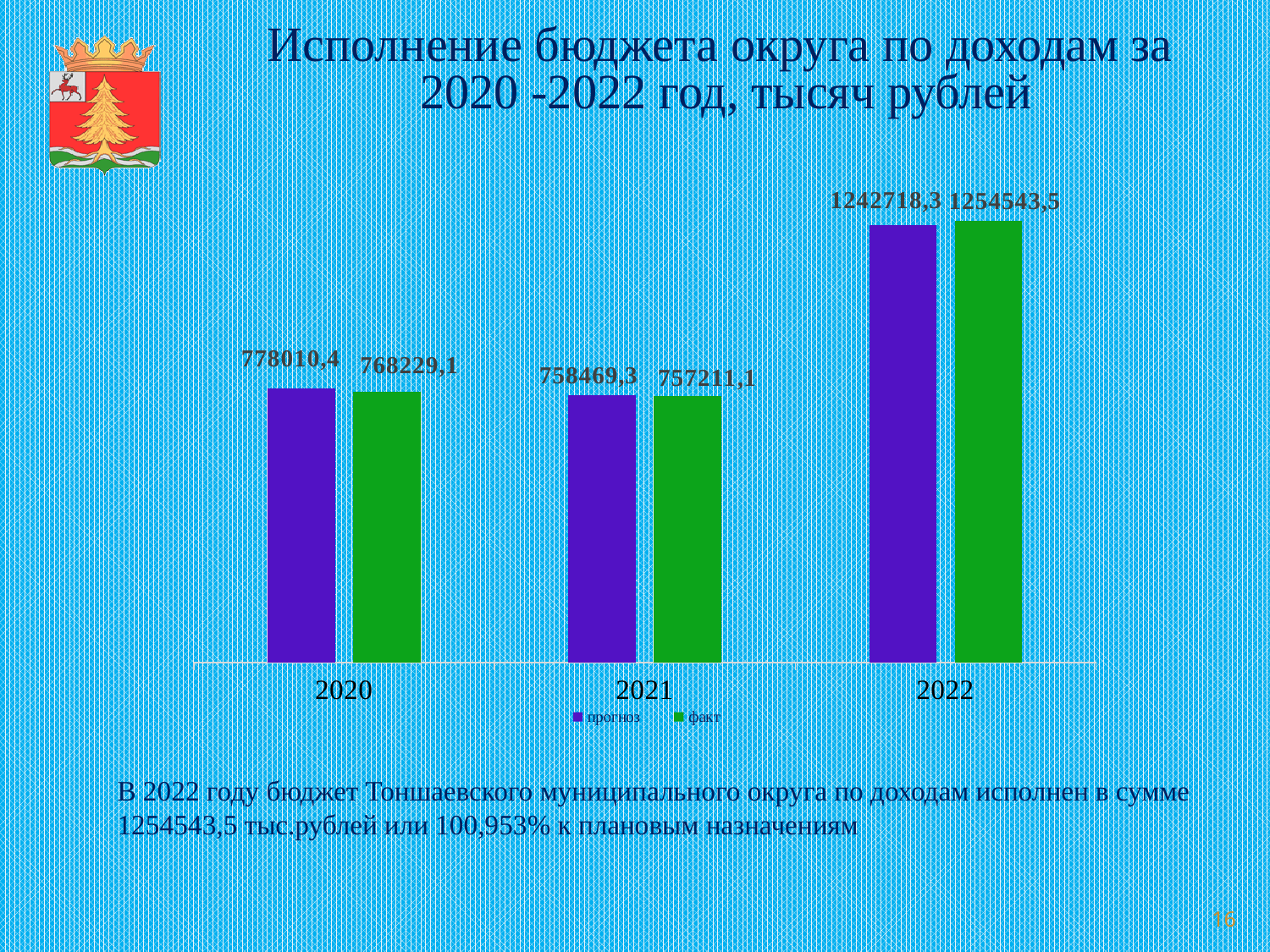
What is the факт value for 2021? 757211,1 For 2022, which is larger: прогноз or факт? факт How many years are shown on the x axis? 3 What kind of chart is shown on the slide? bar chart What is the прогноз value for 2020? 778010,4 Which year has the highest факт value? 2022 How many series does the legend list? 2 What is the difference between the прогноз and факт values for 2020? 9781,3 What is the факт value for 2022? 1254543,5 What is the difference between the факт and прогноз values for 2022? 11825,2 Which year has the lowest прогноз value? 2021 What is the прогноз value for 2022? 1242718,3